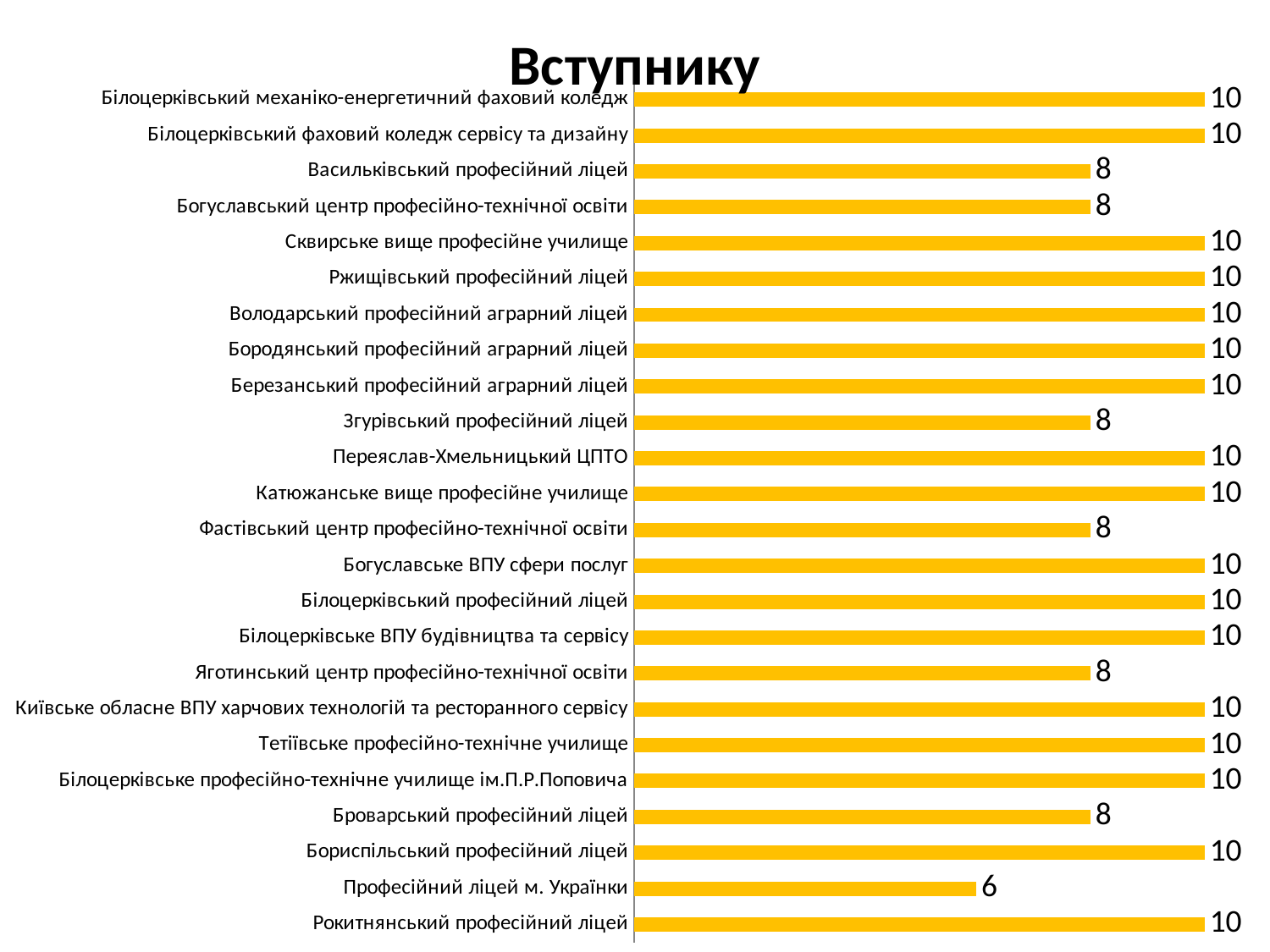
What is the value for Васильківський професійний ліцей? 8 How many categories are shown in the chart? 24 What is the difference between the values for Бориспільський професійний ліцей and Професійний ліцей м. Українки? 4 What kind of chart is this? bar chart What is the value for Професійний ліцей м. Українки? 6 Which category has the lowest value? Професійний ліцей м. Українки What is the title of the chart? Вступнику What is the value for Фастівський центр професійно-технічної освіти? 8 What is the difference between the values for Сквирське вище професійне училище and Згурівський професійний ліцей? 2 How many categories have a value of 8? 6 Which is larger, the value for Броварський професійний ліцей or the value for Тетіївське професійно-технічне училище? Тетіївське професійно-технічне училище What is the value for Рокитнянський професійний ліцей? 10